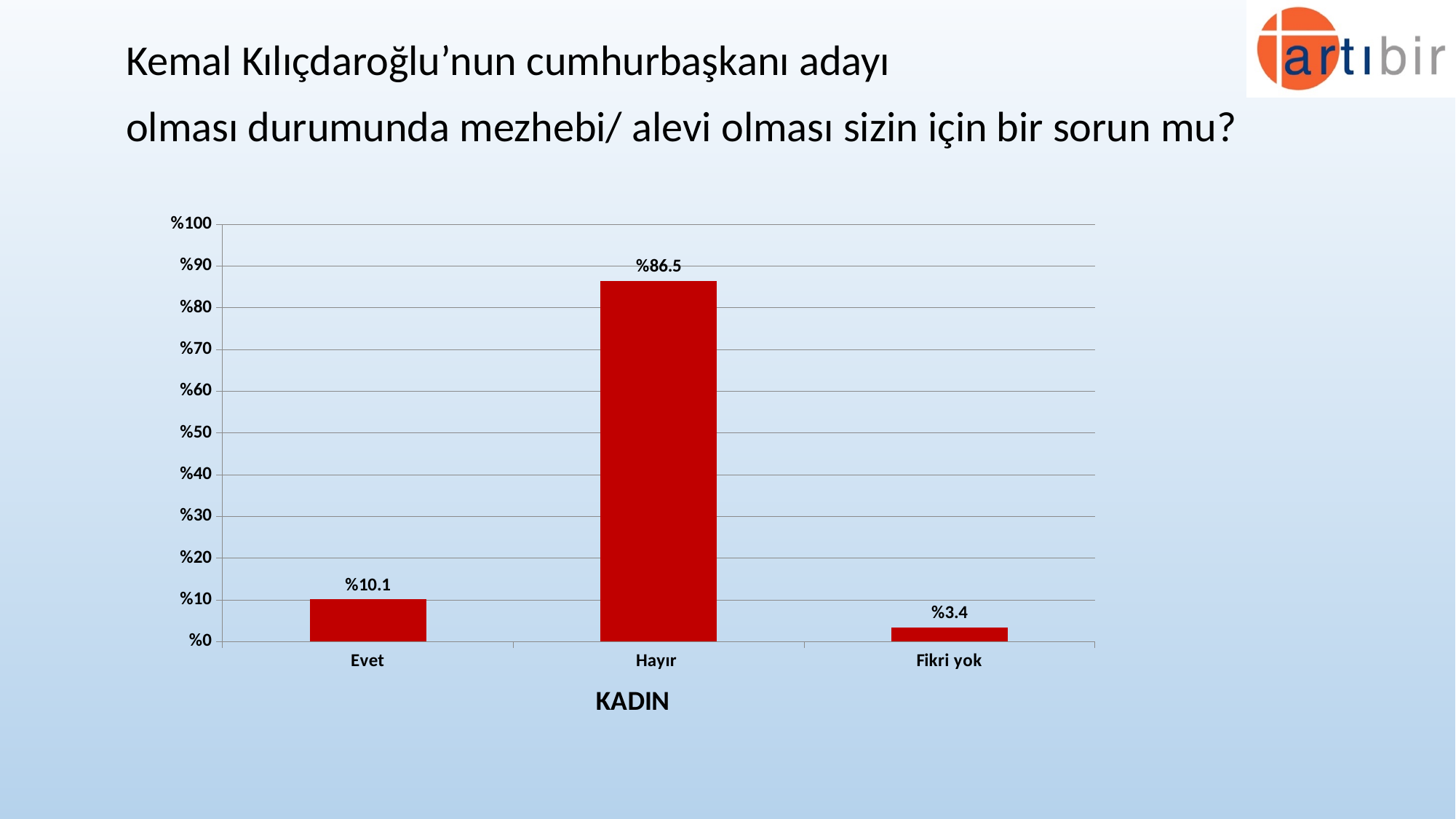
What is the difference between the values for Evet and Fikri yok? %6.7 How many categories are shown on the x axis? 3 Is the value for Hayır greater or less than %80? greater Which is larger, the value for Evet or the value for Fikri yok? Evet What is the value for Fikri yok? %3.4 What is the value for Hayır? %86.5 What is the difference between the values for Hayır and Evet? %76.4 What kind of chart is shown on the slide? bar chart Which category has the highest value? Hayır What is the value for Evet? %10.1 What label appears below the x axis of the chart? KADIN Which category has the lowest value? Fikri yok